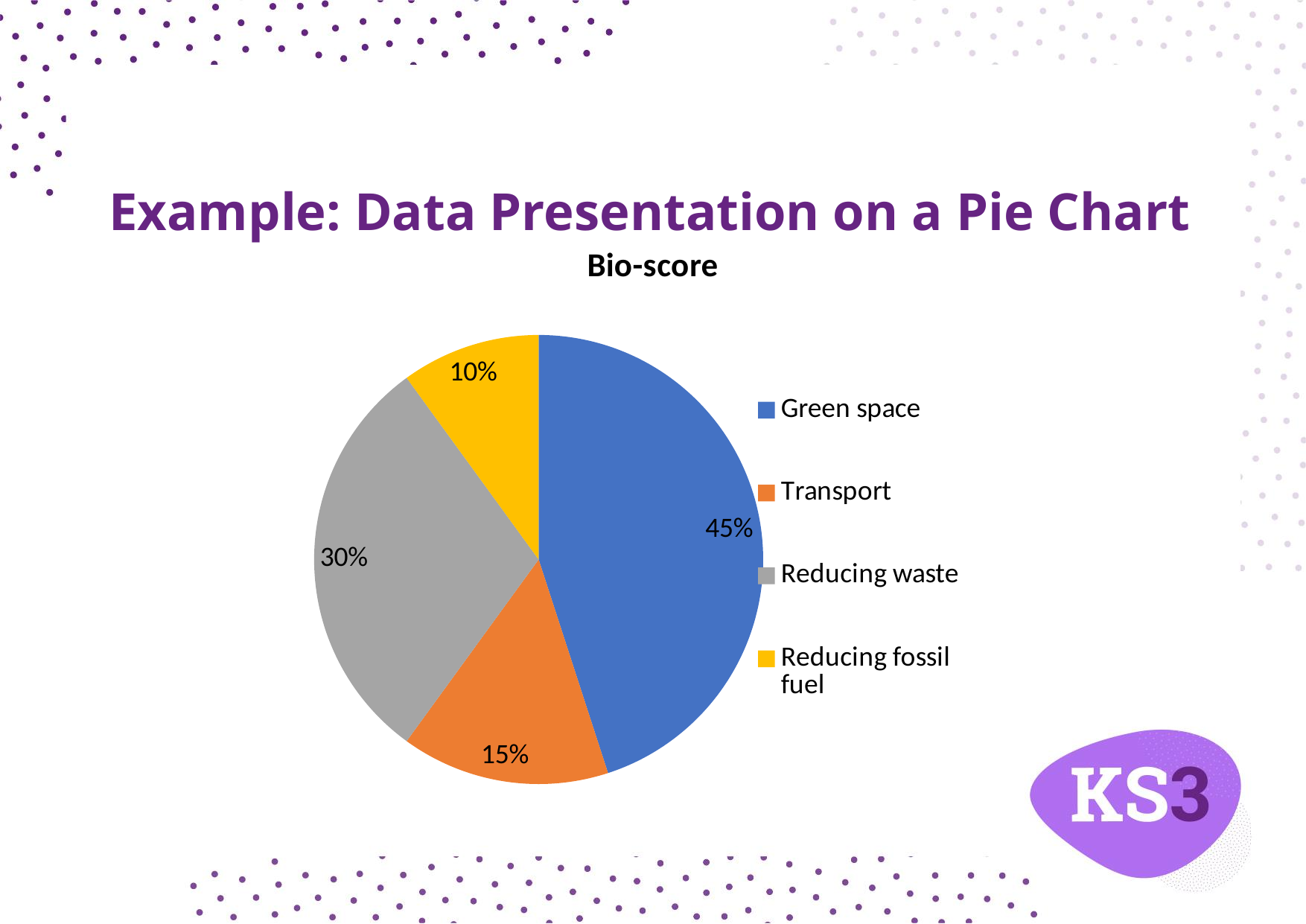
What percentage of the pie is Reducing fossil fuel? 10% Which category has the smallest share of the pie? Reducing fossil fuel What is the difference in percentage points between Green space and Reducing waste? 15 What colour is the Reducing waste slice? grey What percentage of the pie is Green space? 45% Which category has the largest share of the pie? Green space What percentage of the pie is Reducing waste? 30% What percentage of the pie is Transport? 15% Which is larger, the share for Transport or the share for Reducing fossil fuel? Transport What is the title of the chart? Bio-score What type of chart is shown on the slide? pie chart How many categories does the pie chart show? 4